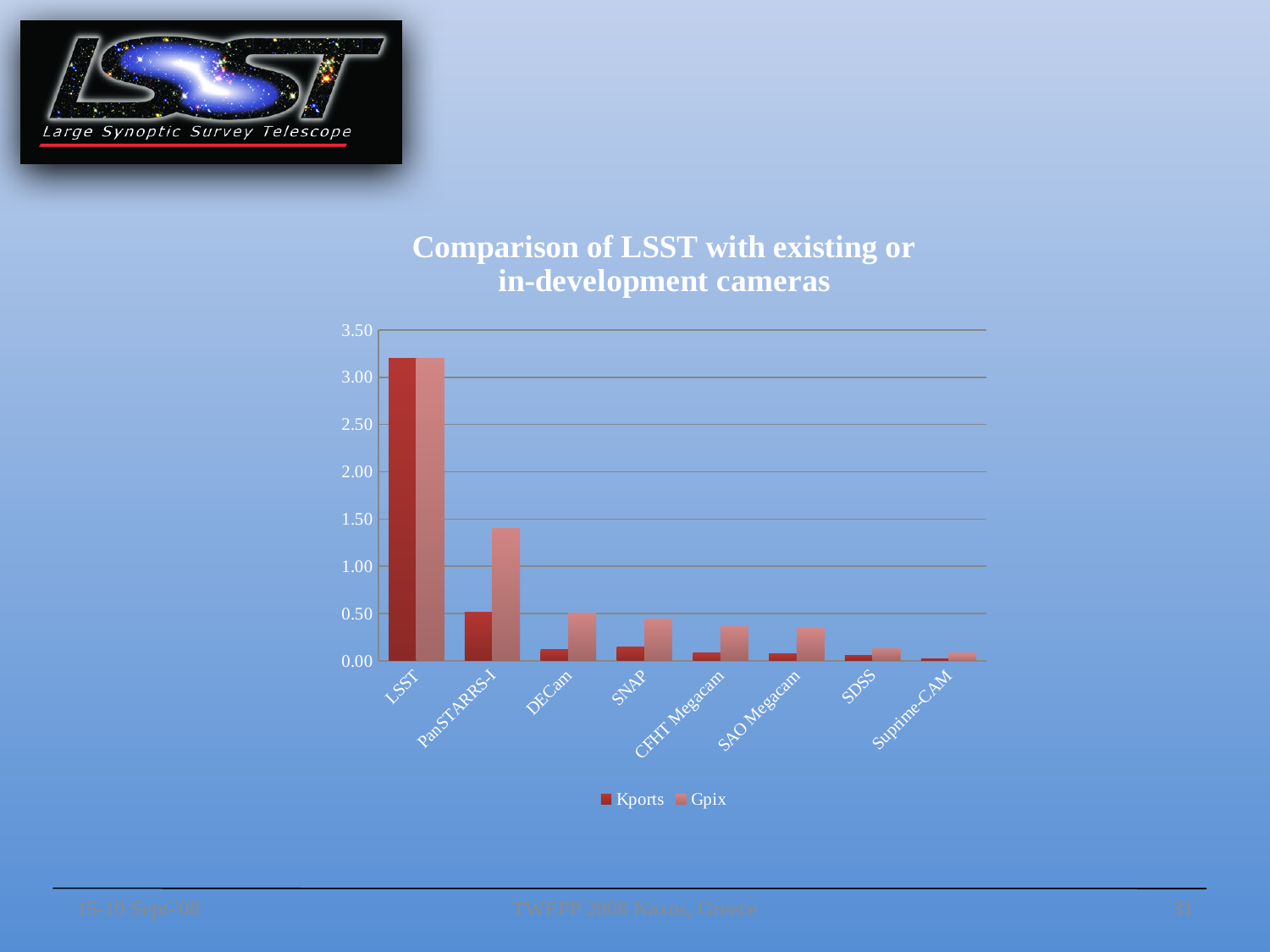
Which camera has the lowest Gpix value? Suprime-CAM Do the Gpix values generally rise or fall moving from left to right along the x axis? fall Is the Gpix value for SNAP greater or less than 0.50? less What kind of chart is shown on the slide? bar chart What is the title of the chart? Comparison of LSST with existing or in-development cameras Which camera has the highest Gpix value? LSST Is the Gpix value for PanSTARRS-I greater or less than 1.00? greater Which is larger for PanSTARRS-I, the Kports value or the Gpix value? Gpix How many cameras are shown on the x axis? 8 What are the two series named in the legend? Kports and Gpix Is the Kports value for LSST greater or less than 3.00? greater How many series does the legend list? 2